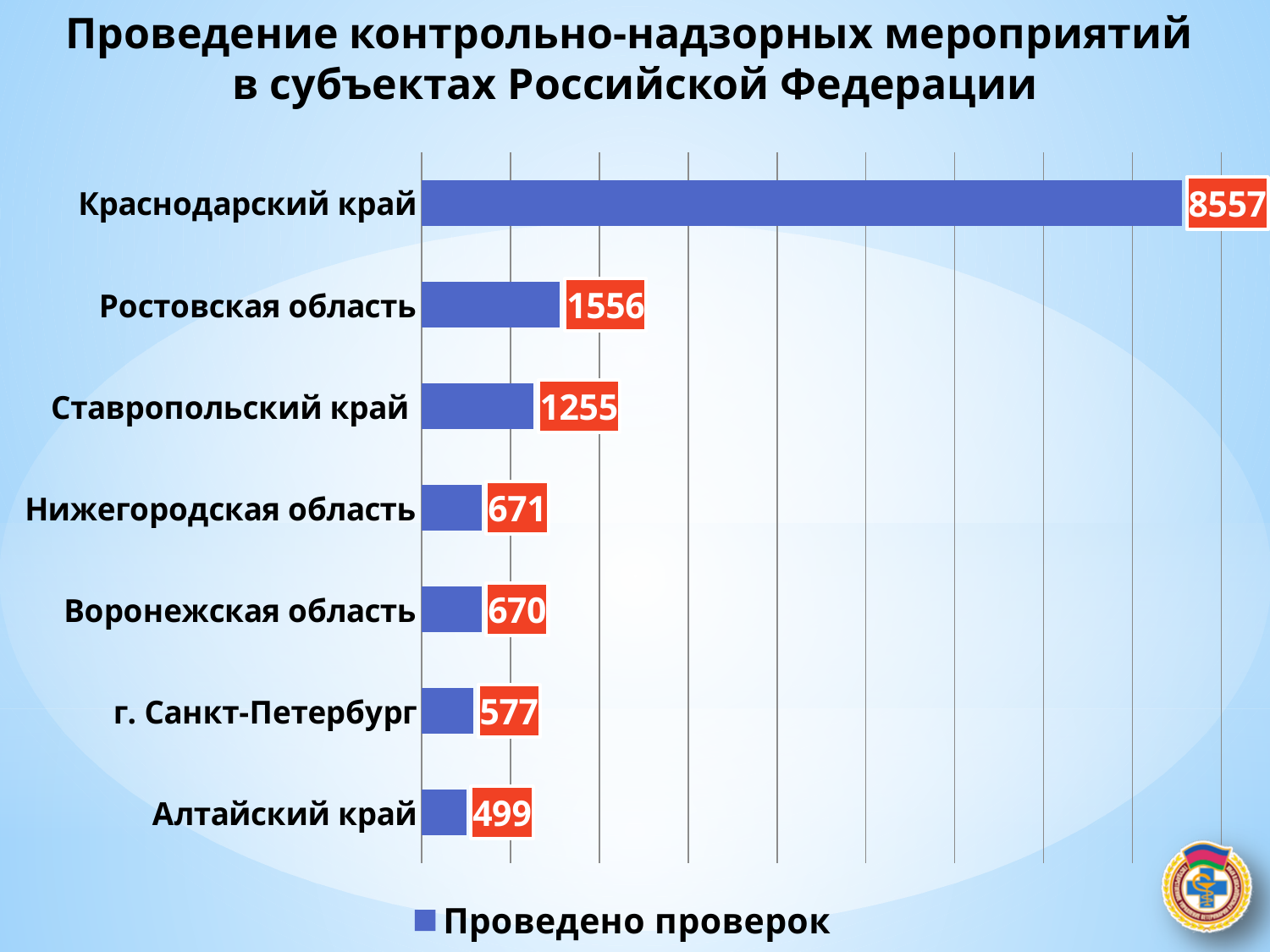
How many regions are shown in the chart? 7 What is the legend entry for the series shown? Проведено проверок What is the difference between the values for Ростовская область and Ставропольский край? 301 Which is larger, the value for Ставропольский край or the value for г. Санкт-Петербург? Ставропольский край What is the value for Ростовская область? 1556 What is the value for Краснодарский край? 8557 What kind of chart is shown on the slide? bar chart What is the value for г. Санкт-Петербург? 577 How many series does the legend list? 1 What is the difference between the values for Нижегородская область and Воронежская область? 1 Which region has the highest value? Краснодарский край Which region has the lowest value? Алтайский край